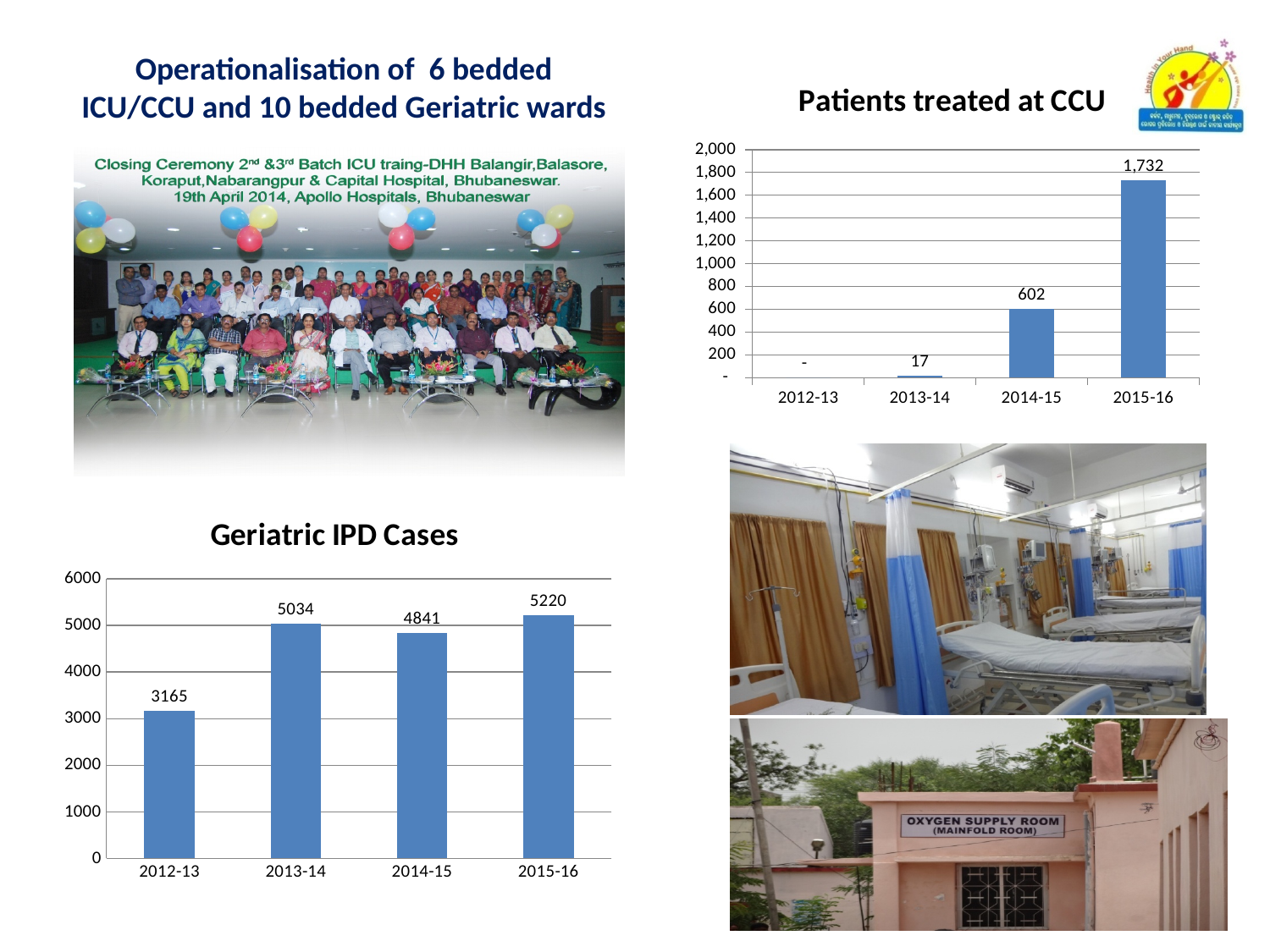
In the 'Geriatric IPD Cases' chart, what is the difference between the 2013-14 and 2014-15 values? 193 In the 'Patients treated at CCU' chart, what is the value for 2014-15? 602 In the 'Patients treated at CCU' chart, how many patients were treated in 2015-16? 1,732 In the 'Geriatric IPD Cases' chart, which year has the highest value? 2015-16 In the 'Patients treated at CCU' chart, what is the value for 2013-14? 17 In the 'Patients treated at CCU' chart, which year has the highest value? 2015-16 In the 'Geriatric IPD Cases' chart, which year has the lowest value? 2012-13 In the 'Geriatric IPD Cases' chart, what is the value for 2012-13? 3165 In the 'Geriatric IPD Cases' chart, what is the value for 2014-15? 4841 In the 'Patients treated at CCU' chart, what is the difference between the 2015-16 and 2014-15 values? 1,130 In the 'Patients treated at CCU' chart, do the values rise or fall from 2013-14 to 2015-16? rise What type of chart is the 'Geriatric IPD Cases' chart? bar chart